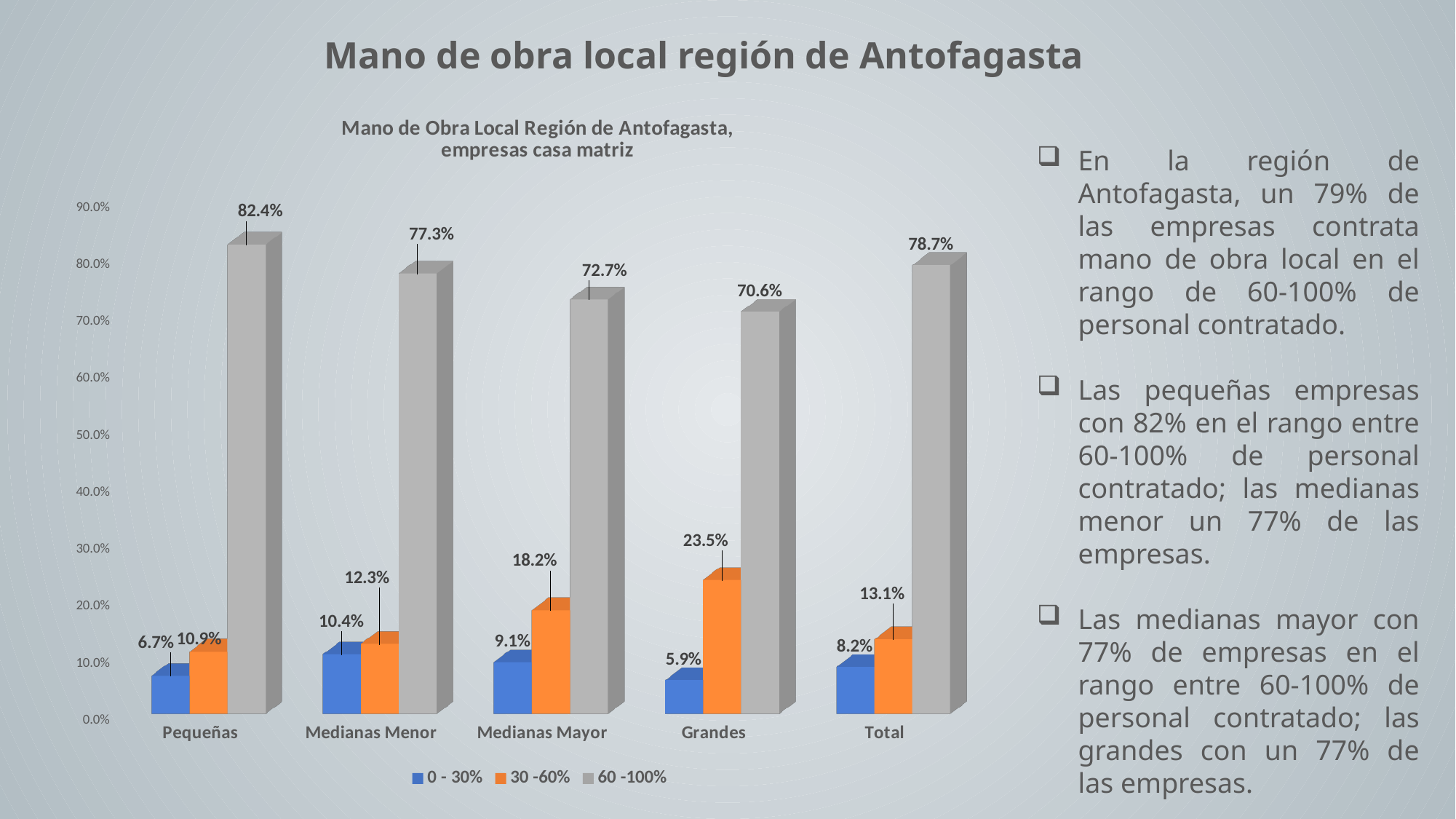
What is the value of the 30 -60% series for Grandes? 23.5% Which is larger, the 30 -60% value for Medianas Mayor or for Medianas Menor? Medianas Mayor What is the value of the 60 -100% series for Pequeñas? 82.4% How many series does the legend list? 3 What is the title of the chart? Mano de Obra Local Región de Antofagasta, empresas casa matriz Which category has the lowest value in the 0 - 30% series? Grandes What kind of chart is shown on the slide? Bar chart What is the value of the 60 -100% series for Total? 78.7% What is the difference between the 60 -100% values for Pequeñas and Grandes? 11.8% Which category has the highest value in the 60 -100% series? Pequeñas How many categories are shown on the x axis? 5 What is the value of the 0 - 30% series for Medianas Menor? 10.4%